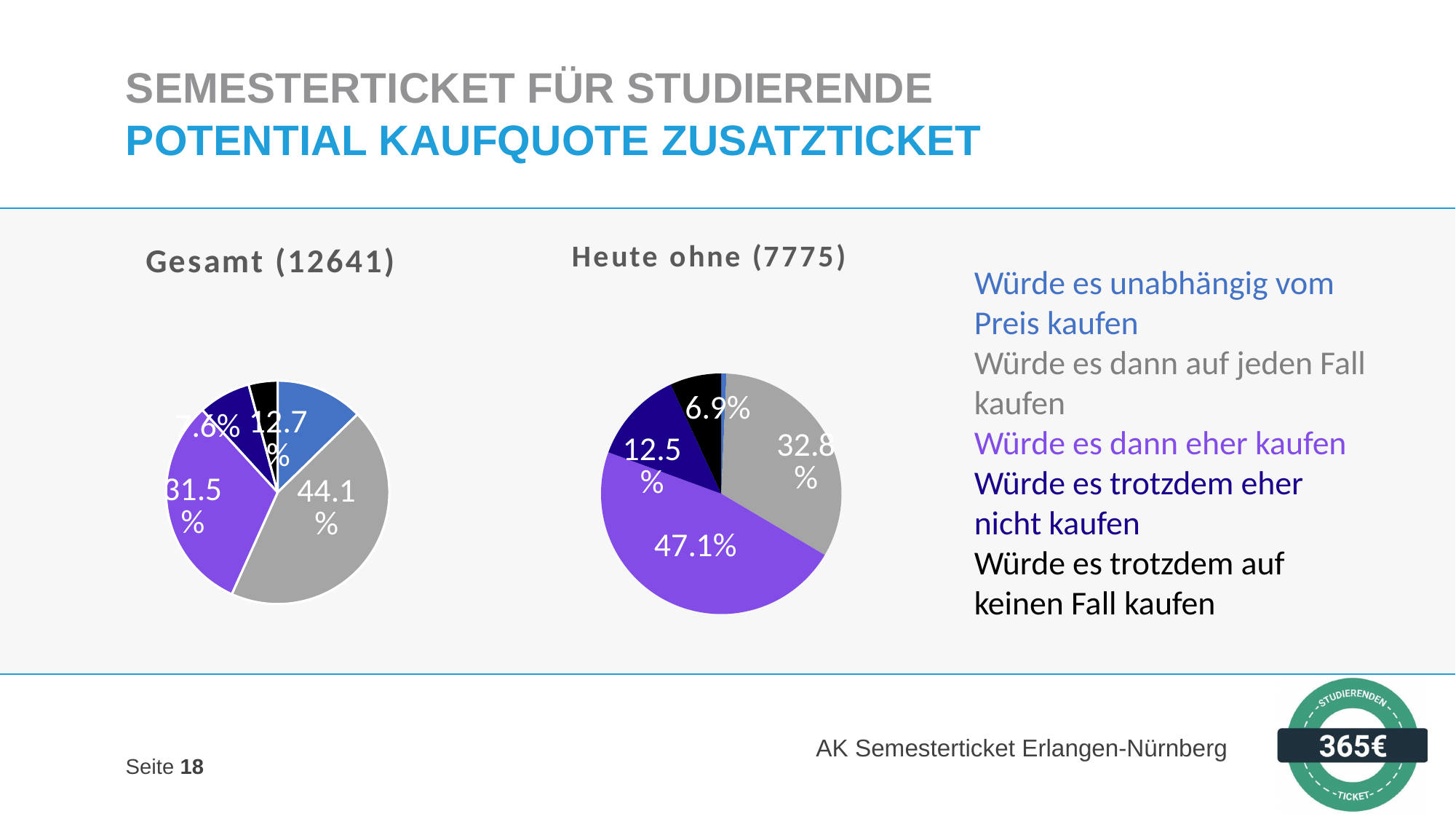
In the 'Gesamt (12641)' pie chart, what share is shown for 'Würde es unabhängig vom Preis kaufen' (blue slice)? 12.7% In the 'Gesamt (12641)' pie chart, what share is shown for 'Würde es trotzdem eher nicht kaufen' (dark blue slice)? 7.6% In the 'Heute ohne (7775)' pie chart, which category has the largest slice? Würde es dann eher kaufen In the 'Heute ohne (7775)' pie chart, what share is shown for 'Würde es dann auf jeden Fall kaufen' (grey slice)? 32.8% In the 'Gesamt (12641)' pie chart, which category has the largest slice? Würde es dann auf jeden Fall kaufen How many categories does the legend on the slide list? 5 In the 'Heute ohne (7775)' pie chart, what share is shown for 'Würde es trotzdem auf keinen Fall kaufen' (black slice)? 6.9% In the 'Heute ohne (7775)' pie chart, what share is shown for 'Würde es dann eher kaufen' (purple slice)? 47.1% In the 'Gesamt (12641)' pie chart, what share is shown for 'Würde es dann eher kaufen' (purple slice)? 31.5% What type of chart is used for 'Gesamt (12641)' and 'Heute ohne (7775)'? Pie chart In the 'Heute ohne (7775)' pie chart, what is the difference between the 'Würde es dann eher kaufen' slice and the 'Würde es dann auf jeden Fall kaufen' slice? 14.3% In the 'Gesamt (12641)' pie chart, what share is shown for 'Würde es dann auf jeden Fall kaufen' (grey slice)? 44.1%